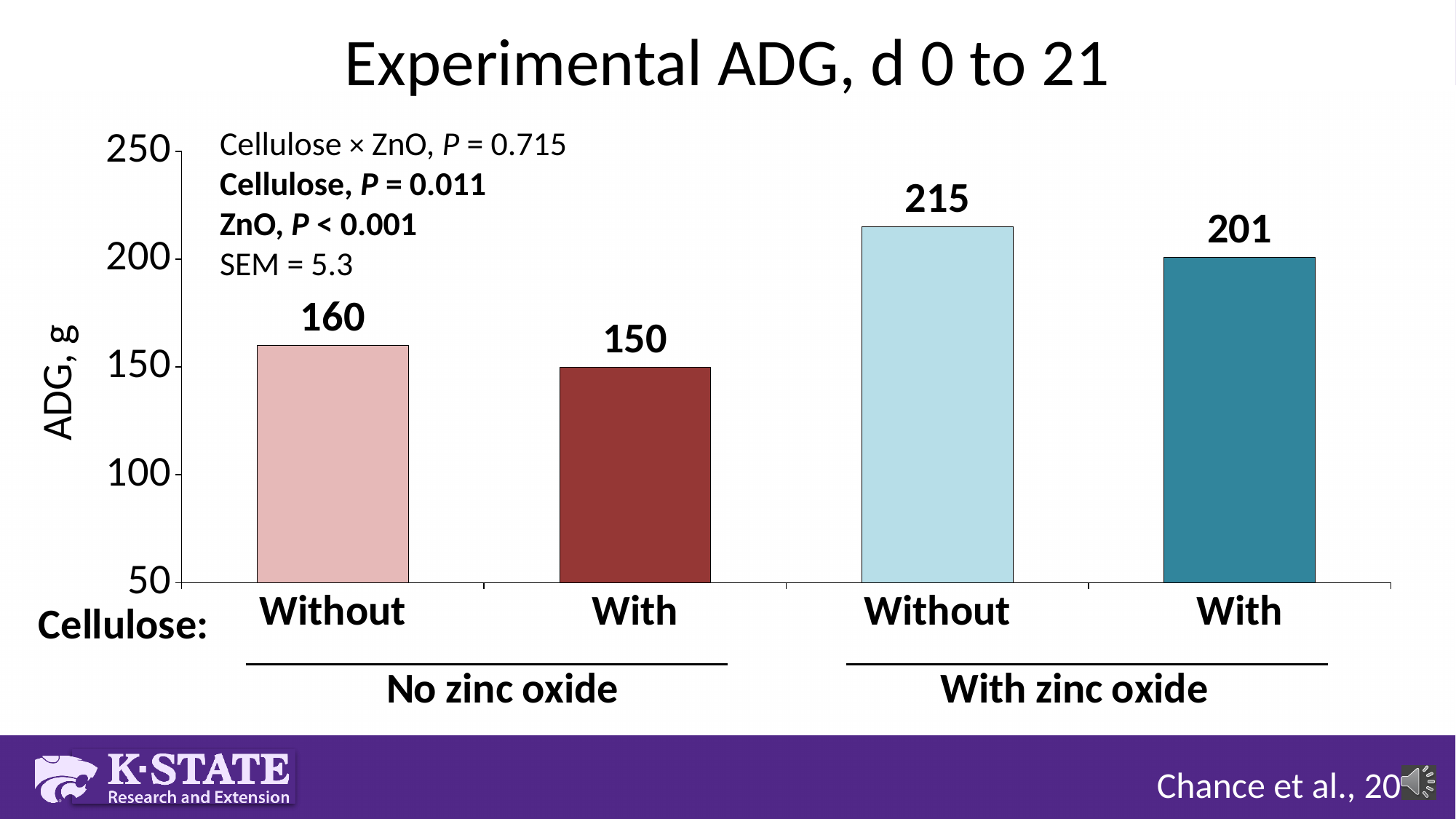
Which is larger: the ADG for With cellulose under No zinc oxide or With cellulose under With zinc oxide? With cellulose under With zinc oxide What is the ADG for the Without cellulose, No zinc oxide group? 160 What is the difference in ADG between the Without and With cellulose groups under With zinc oxide? 14 Which group has the lowest ADG? With cellulose, No zinc oxide What kind of chart is shown on the slide? Bar chart What is the ADG for the Without cellulose, With zinc oxide group? 215 How many bars are shown in the chart? 4 What is the SEM value shown on the chart? 5.3 What is the ADG for the With cellulose, With zinc oxide group? 201 What is the title of the chart? Experimental ADG, d 0 to 21 Which group has the highest ADG? Without cellulose, With zinc oxide What is the difference in ADG between the Without and With cellulose groups under No zinc oxide? 10